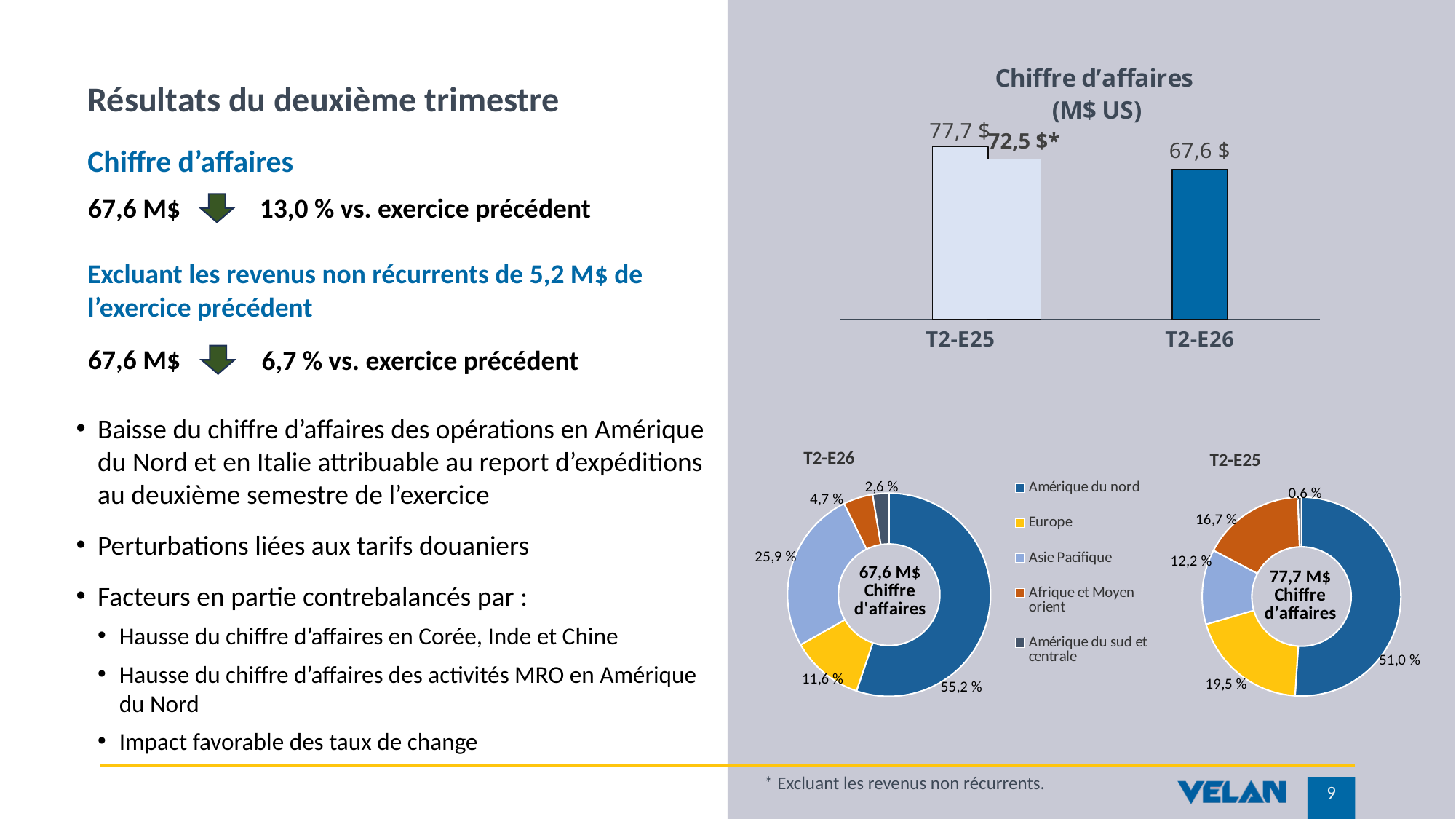
Is the share of Asie Pacifique larger in the T2-E26 donut chart or in the T2-E25 donut chart? T2-E26 In the bar chart 'Chiffre d'affaires (M$ US)', what is the value shown for T2-E26? 67,6 $ In the bar chart 'Chiffre d'affaires (M$ US)', what is the value of the taller bar for T2-E25? 77,7 $ In the T2-E26 donut chart, what share does Amérique du nord represent? 55,2 % In the bar chart 'Chiffre d'affaires (M$ US)', what is the difference between the 77,7 $ bar for T2-E25 and the T2-E26 bar? 10,1 $ In the T2-E25 donut chart, what share does Afrique et Moyen orient represent? 16,7 % In the T2-E26 donut chart, what share does Asie Pacifique represent? 25,9 % In the bar chart 'Chiffre d'affaires (M$ US)', what is the value of the T2-E25 bar marked with an asterisk (excluding non-recurring revenue)? 72,5 $* In the T2-E25 donut chart, which region has the smallest share? Amérique du sud et centrale What total revenue is shown in the centre of the T2-E25 donut chart? 77,7 M$ How many regions does the legend between the two donut charts list? 5 What kind of chart is the 'Chiffre d'affaires (M$ US)' chart at the top right? Bar chart